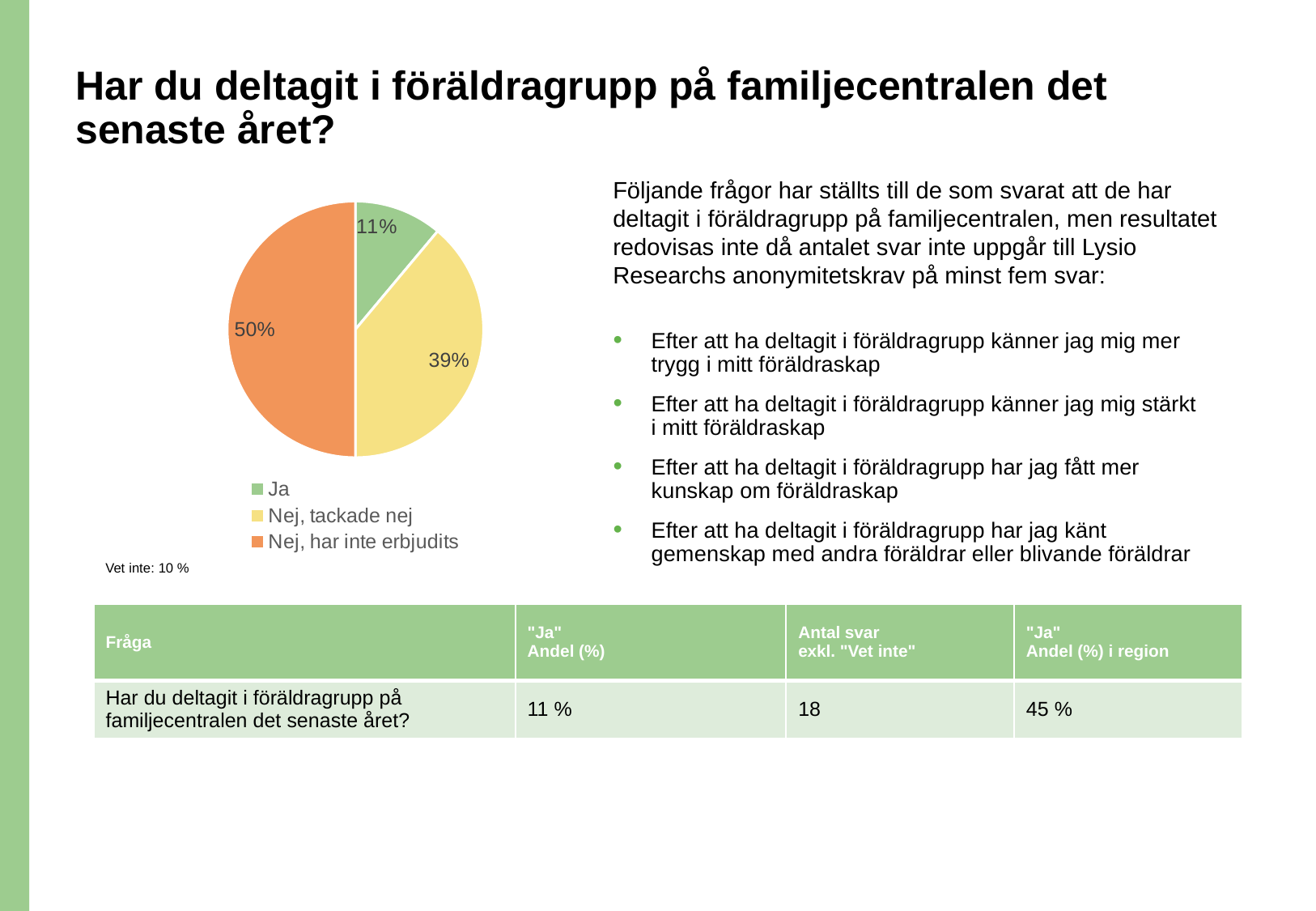
What is the difference in percentage points between "Nej, har inte erbjudits" and "Nej, tackade nej"? 11 What colour is the "Ja" slice in the pie chart? green What is the difference in percentage points between "Nej, tackade nej" and "Ja"? 28 What share of the pie does "Nej, tackade nej" represent? 39% Which category has the largest slice of the pie? Nej, har inte erbjudits How many categories does the pie chart have? 3 Which category has the smallest slice of the pie? Ja What percentage is given for "Vet inte" below the chart? 10 % What kind of chart is shown on the slide? pie chart What share of the pie does "Nej, har inte erbjudits" represent? 50% Which is larger, the slice for "Ja" or the slice for "Nej, tackade nej"? Nej, tackade nej What share of the pie does "Ja" represent? 11%